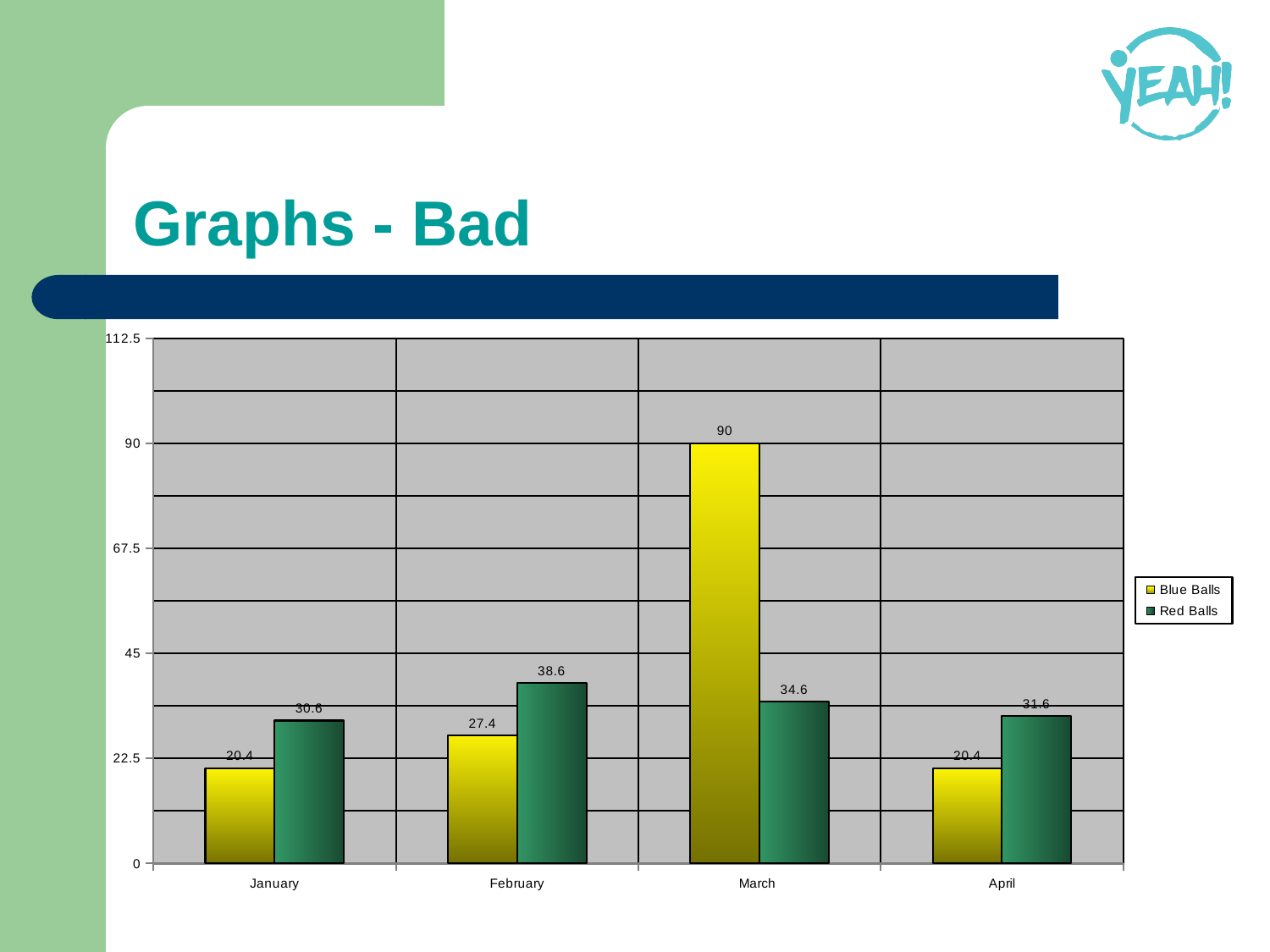
What kind of chart is shown on the slide? bar chart How many series does the legend list? 2 Is the value for Red Balls in March greater or less than 45? less What is the value for Blue Balls in January? 20.4 Which month has the highest value for Blue Balls? March Which is larger in February, Blue Balls or Red Balls? Red Balls What is the value for Red Balls in April? 31.6 What is the value for Red Balls in February? 38.6 What is the difference between Blue Balls and Red Balls in March? 55.4 What is the value for Blue Balls in March? 90 How many months are shown on the x axis? 4 Which month has the lowest value for Red Balls? January